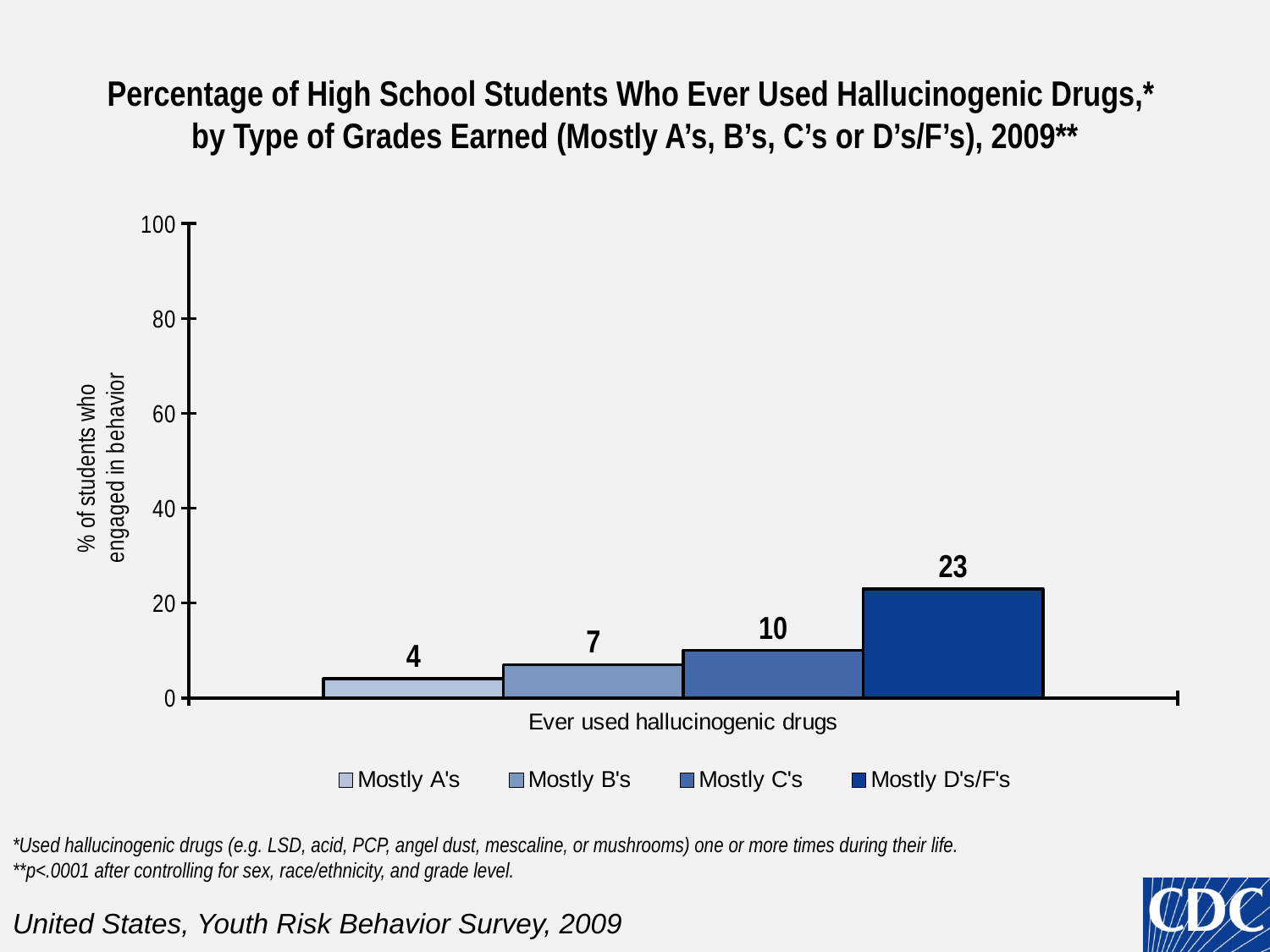
Which is larger: the value for Mostly B's or the value for Mostly C's? Mostly C's What percentage of students with Mostly D's/F's ever used hallucinogenic drugs? 23 What is the label on the y axis of the chart? % of students who engaged in behavior What percentage of students with Mostly A's ever used hallucinogenic drugs? 4 What kind of chart is shown on the slide? Bar chart Which grade group has the lowest percentage of students who ever used hallucinogenic drugs? Mostly A's What is the difference in percentage between students with Mostly D's/F's and students with Mostly A's? 19 Which grade group has the highest percentage of students who ever used hallucinogenic drugs? Mostly D's/F's What percentage of students with Mostly C's ever used hallucinogenic drugs? 10 What percentage of students with Mostly B's ever used hallucinogenic drugs? 7 How many series does the legend list? 4 Is the value for Mostly D's/F's greater or less than 20? greater